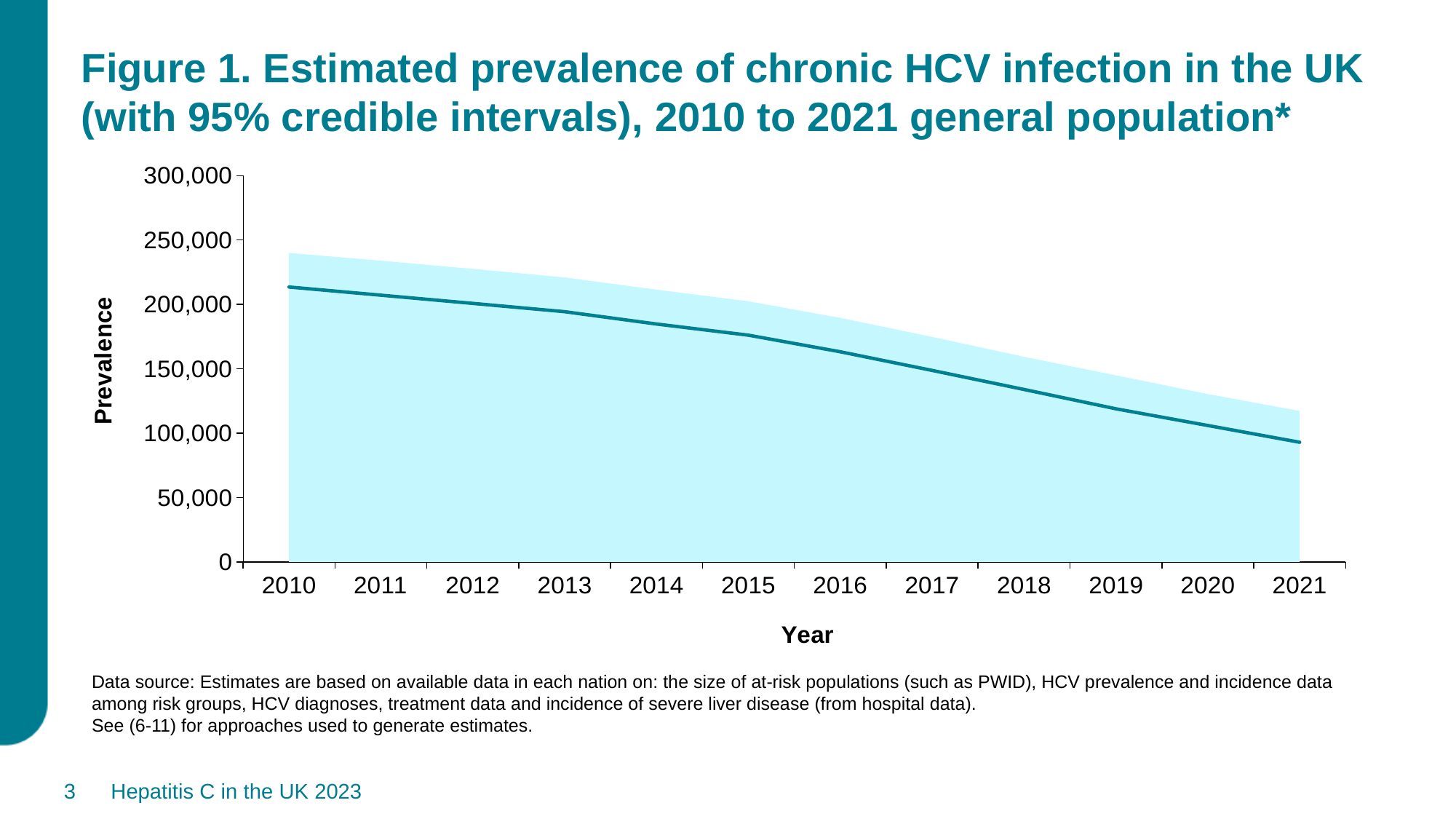
What kind of chart is shown on the slide? Line chart What is the label on the y axis of the chart? Prevalence Which year has the larger estimated prevalence, 2012 or 2017? 2012 How many years are plotted along the x axis? 12 Is the estimated prevalence for 2021 greater or less than 100,000? less Is the estimated prevalence for 2010 greater or less than 200,000? greater Is the estimated prevalence for 2016 greater or less than 150,000? greater Does the estimated prevalence rise or fall from 2010 to 2021? Fall What does the shaded area around the line represent, according to the chart title? 95% credible intervals In which year is the estimated prevalence highest? 2010 In which year is the estimated prevalence lowest? 2021